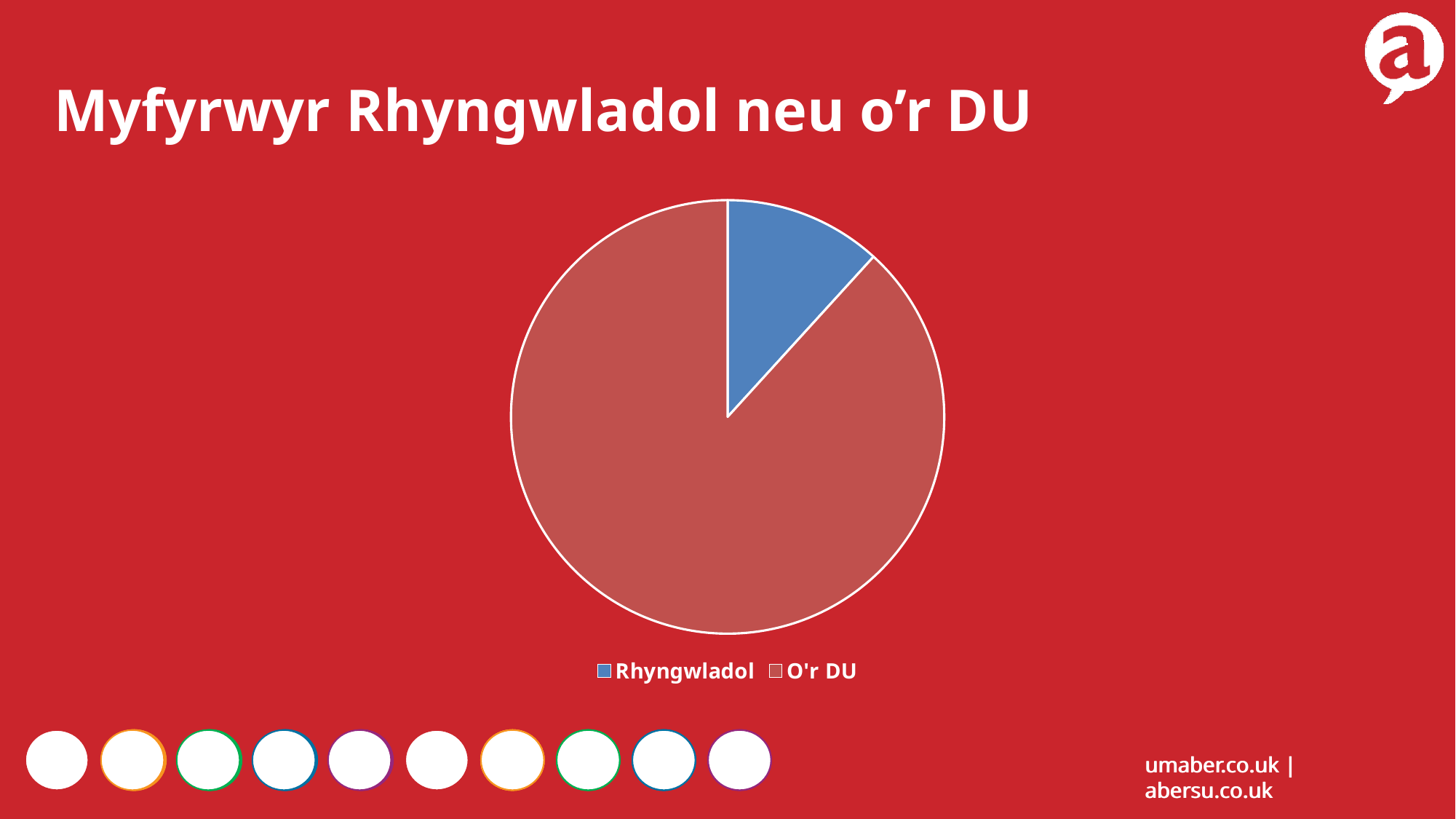
Which slice is larger, Rhyngwladol or O'r DU? O'r DU Which category has the largest slice of the pie chart? O'r DU What colour is the Rhyngwladol slice in the pie chart? blue How many slices does the pie chart have? 2 Which category has the smallest slice of the pie chart? Rhyngwladol What is the title of the slide containing the pie chart? Myfyrwyr Rhyngwladol neu o'r DU What kind of chart is shown on the slide? pie chart How many entries does the legend of the pie chart list? 2